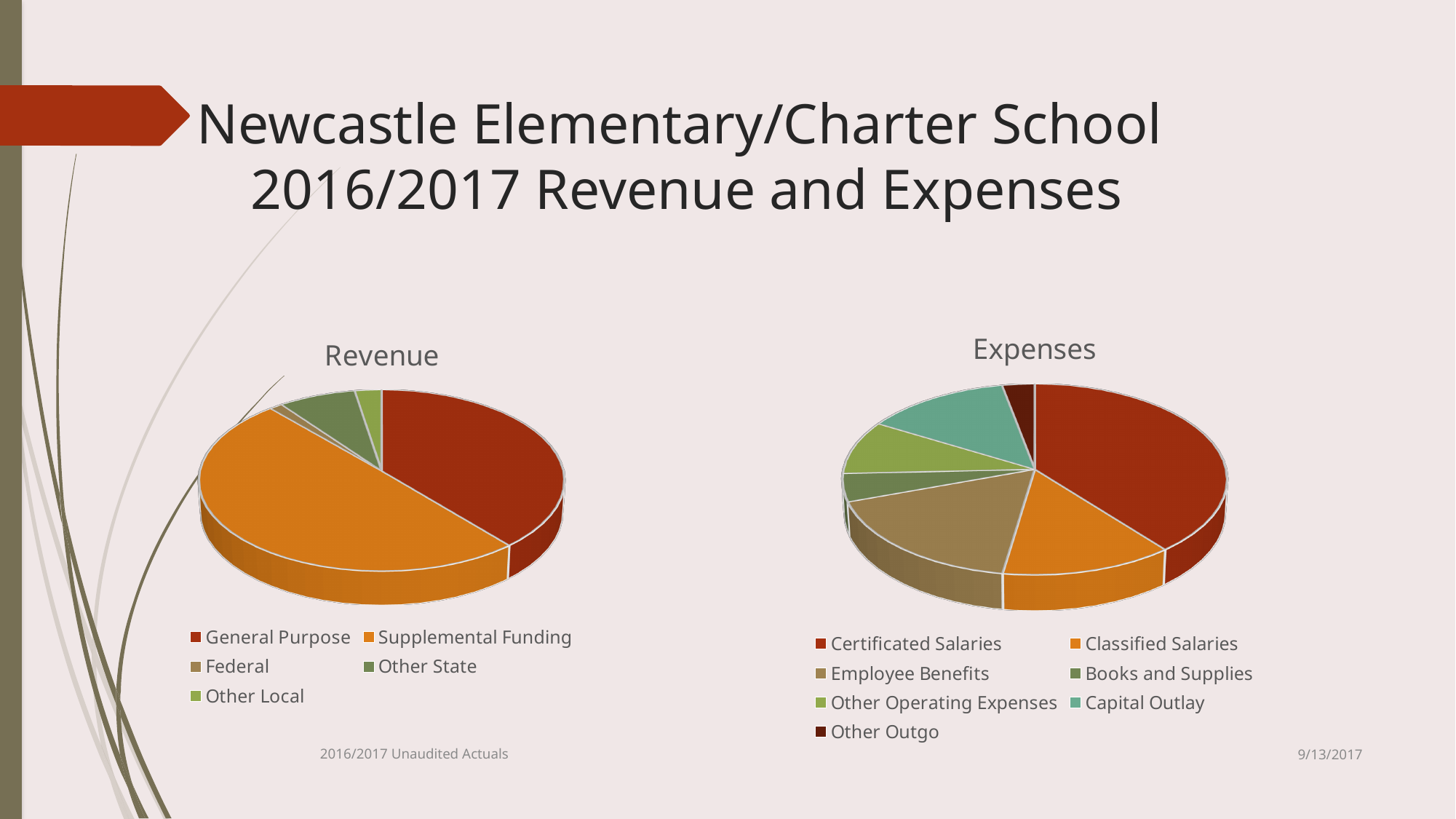
In the Expenses chart, which category has the largest slice? Certificated Salaries In the Revenue chart, how many categories does the legend list? 5 In the Expenses chart, which is larger: Capital Outlay or Other Operating Expenses? Capital Outlay In the Revenue chart, which is larger: General Purpose or Other State? General Purpose In the Revenue chart, which category has the largest slice? Supplemental Funding What kind of chart is the Revenue chart? Pie chart In the Revenue chart, which category has the smallest slice? Federal In the Expenses chart, which is larger: Certificated Salaries or Capital Outlay? Certificated Salaries What is the title of the chart on the left side of the slide? Revenue What kind of chart is the Expenses chart? Pie chart In the Expenses chart, which category is shown in teal? Capital Outlay In the Expenses chart, how many categories does the legend list? 7